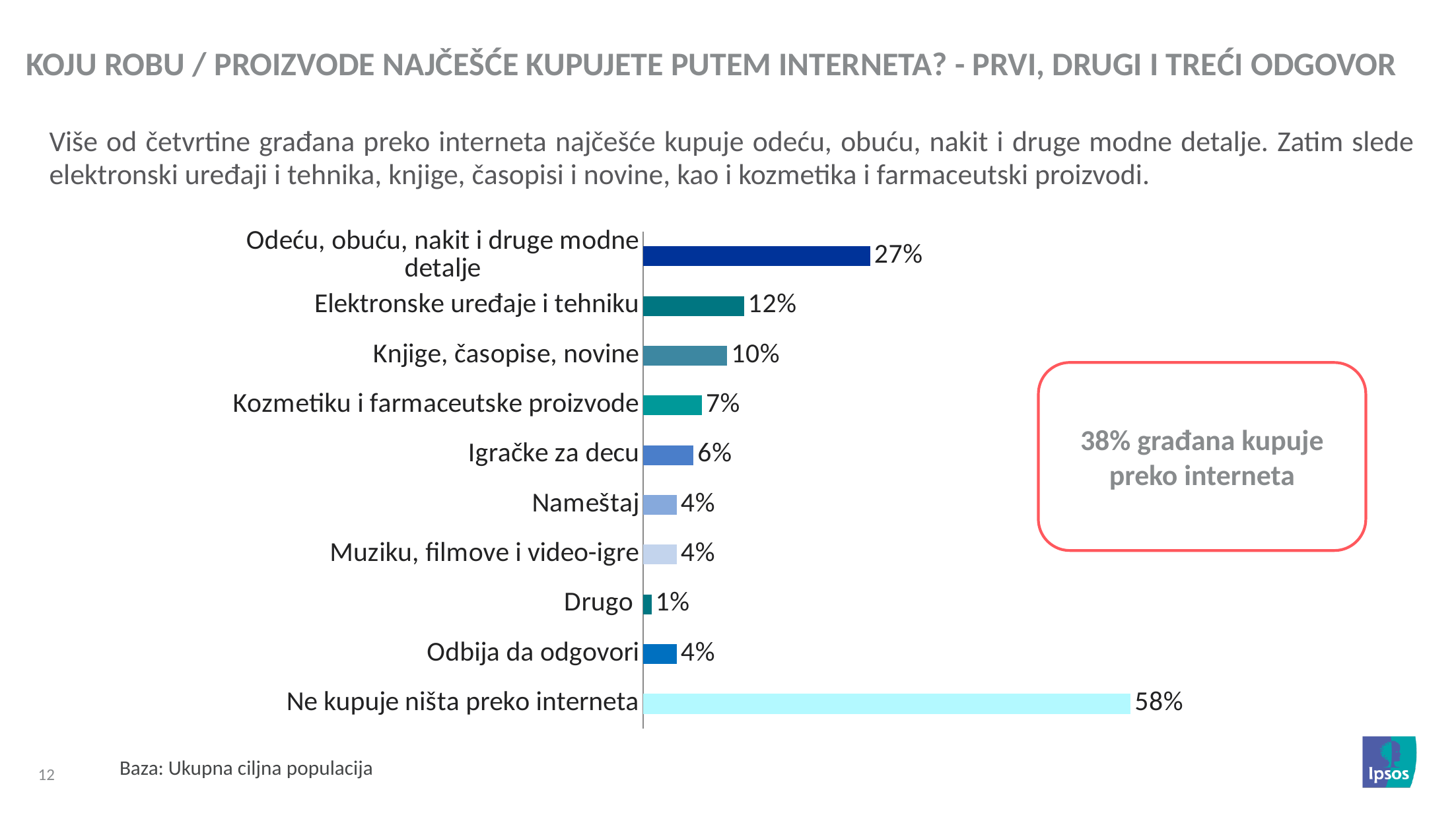
What is the value for Drugo? 1% Which category has the highest value? Ne kupuje ništa preko interneta What is the value for Ne kupuje ništa preko interneta? 58% Which is larger, the value for Knjige, časopise, novine or the value for Igračke za decu? Knjige, časopise, novine What is the value for Elektronske uređaje i tehniku? 12% What kind of chart is shown on the slide? bar chart What is the difference between the values for Ne kupuje ništa preko interneta and Odeću, obuću, nakit i druge modne detalje? 31% What is the difference between the values for Odeću, obuću, nakit i druge modne detalje and Elektronske uređaje i tehniku? 15% What percentage is stated in the red-outlined box on the slide? 38% What is the value for Kozmetiku i farmaceutske proizvode? 7% Which category has the lowest value? Drugo How many categories are shown in the chart? 10